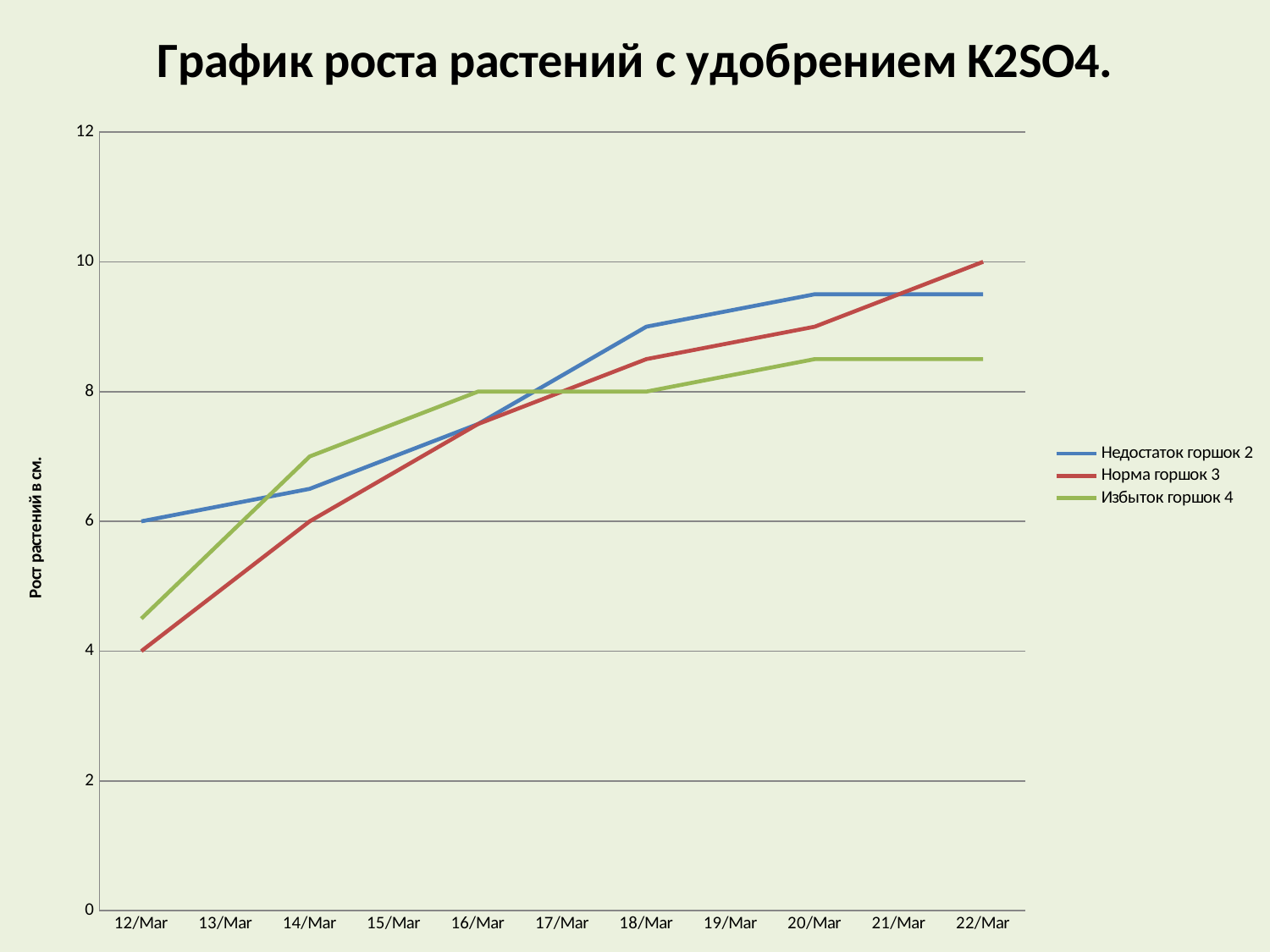
What kind of chart is shown on the slide? Line chart Do the values for Норма горшок 3 rise or fall from 12/Mar to 22/Mar? Rise What is the value for Норма горшок 3 on 22/Mar? 10 What is the value for Норма горшок 3 on 12/Mar? 4 Is the value for Недостаток горшок 2 on 20/Mar greater or less than 8? greater By how much did Норма горшок 3 increase from 12/Mar to 22/Mar? 6 What is the value for Недостаток горшок 2 on 12/Mar? 6 Is the value for Избыток горшок 4 on 22/Mar greater or less than 10? less Which series has the highest value on 22/Mar? Норма горшок 3 Which series has the lowest value on 12/Mar? Норма горшок 3 How many series does the legend list? 3 What is the value for Избыток горшок 4 on 16/Mar? 8